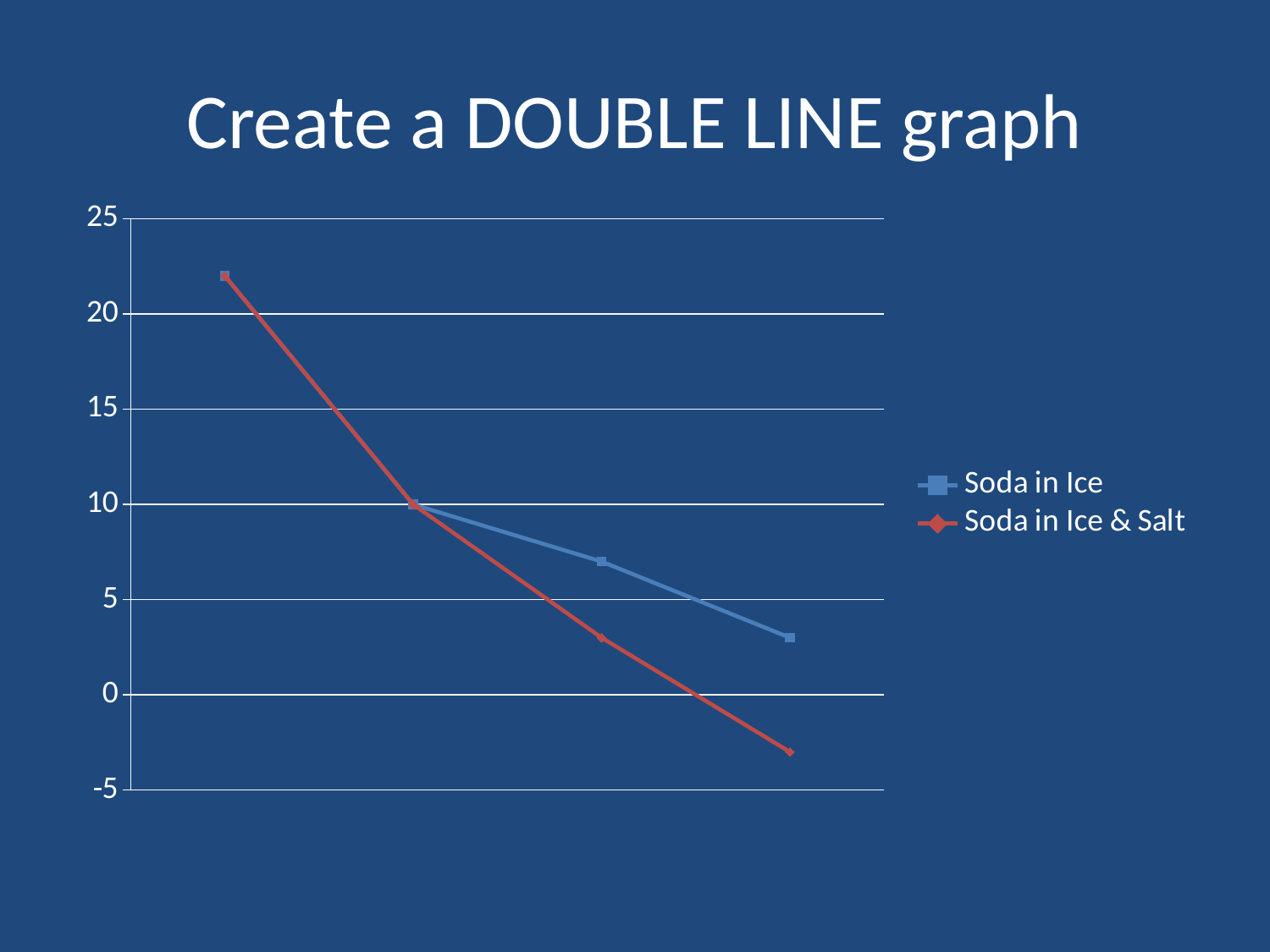
Do the values for Soda in Ice rise or fall from left to right? fall Is the last (rightmost) value for Soda in Ice & Salt greater or less than 0? less What is the title of the slide containing the chart? Create a DOUBLE LINE graph Is the third value for Soda in Ice greater or less than 5? greater Is the first (leftmost) value for Soda in Ice & Salt greater or less than 20? greater What kind of chart is shown on the slide? line chart Which series is drawn in red? Soda in Ice & Salt At the rightmost point, which series has the higher value, Soda in Ice or Soda in Ice & Salt? Soda in Ice Do the values for Soda in Ice & Salt rise or fall from left to right? fall How many series does the legend list? 2 How many data points does each line have? 4